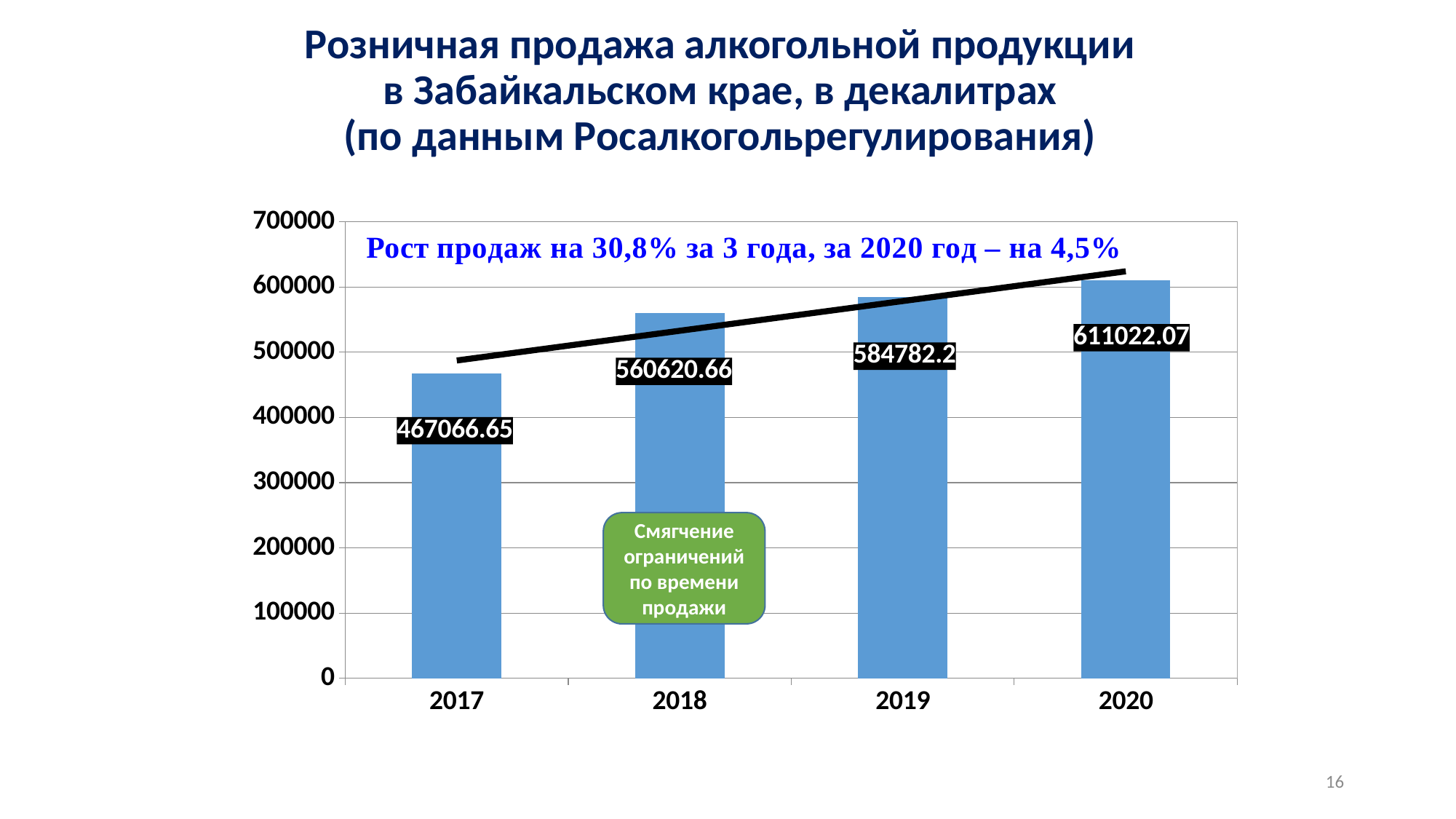
What is the value for 2018? 560620.66 What is the difference between the values for 2019 and 2018? 24161.54 Which year has the highest value? 2020 What is the value for 2017? 467066.65 Which year has the lowest value? 2017 Which is larger, the value for 2018 or the value for 2019? 2019 How many years are shown on the x axis? 4 What is the value for 2020? 611022.07 What is the difference between the values for 2020 and 2017? 143955.42 Is the value for 2017 greater or less than 500000? less Do the values rise or fall from 2017 to 2020? rise What is the value for 2019? 584782.2